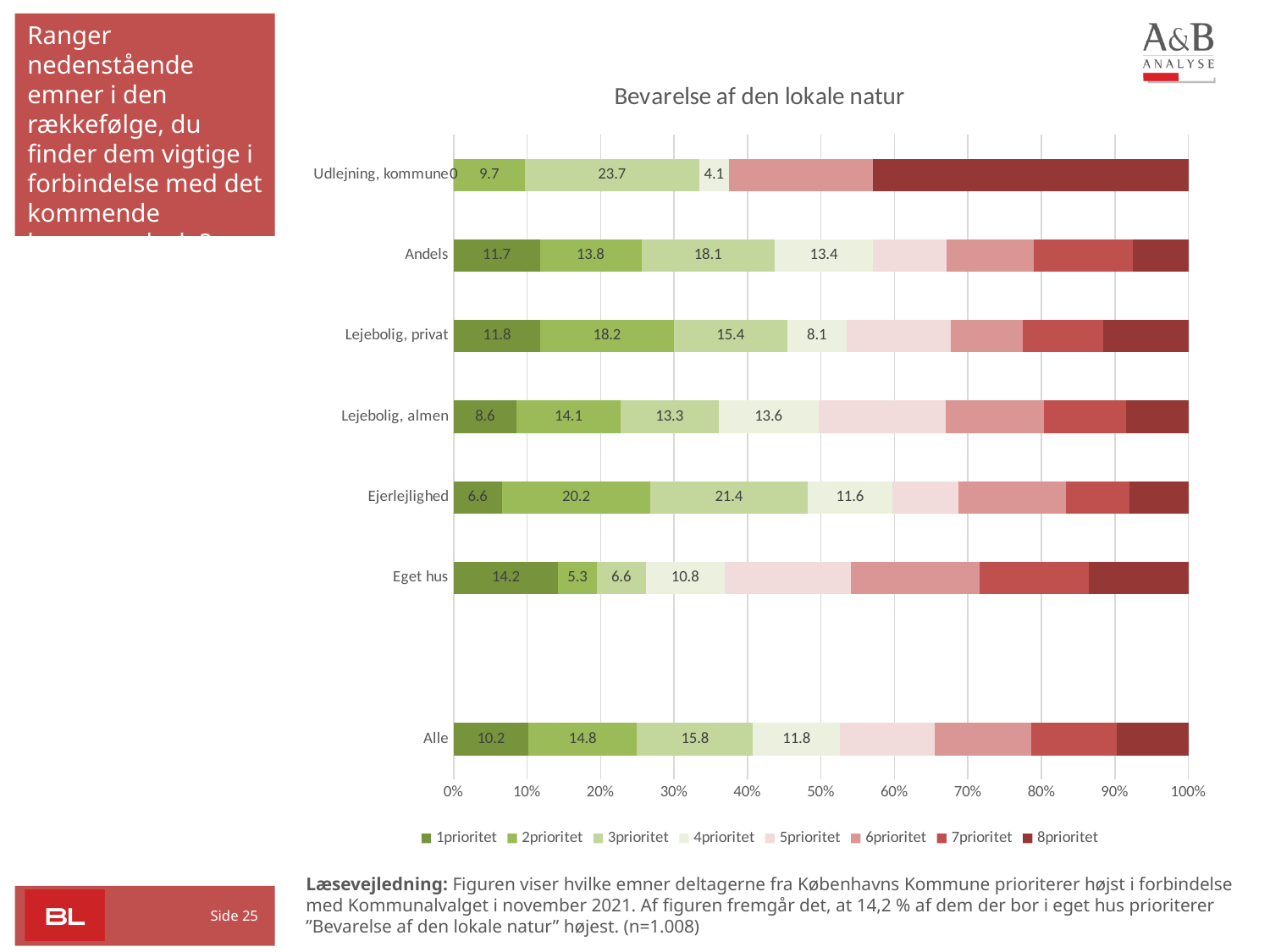
Which category has the highest value for 1prioritet? Eget hus What is the title of the chart? Bevarelse af den lokale natur What kind of chart is shown? Stacked bar chart What is the value of 3prioritet for Udlejning, kommune? 23.7 What is the value of 4prioritet for Alle? 11.8 How many series does the legend list? 8 What is the value of 2prioritet for Ejerlejlighed? 20.2 How many categories are shown on the y axis? 7 What is the difference between the 2prioritet values for Lejebolig, privat and Eget hus? 12.9 Which is larger: the 3prioritet value for Ejerlejlighed or for Andels? Ejerlejlighed Which category has the lowest value for 1prioritet? Udlejning, kommune What is the value of 1prioritet for Eget hus? 14.2